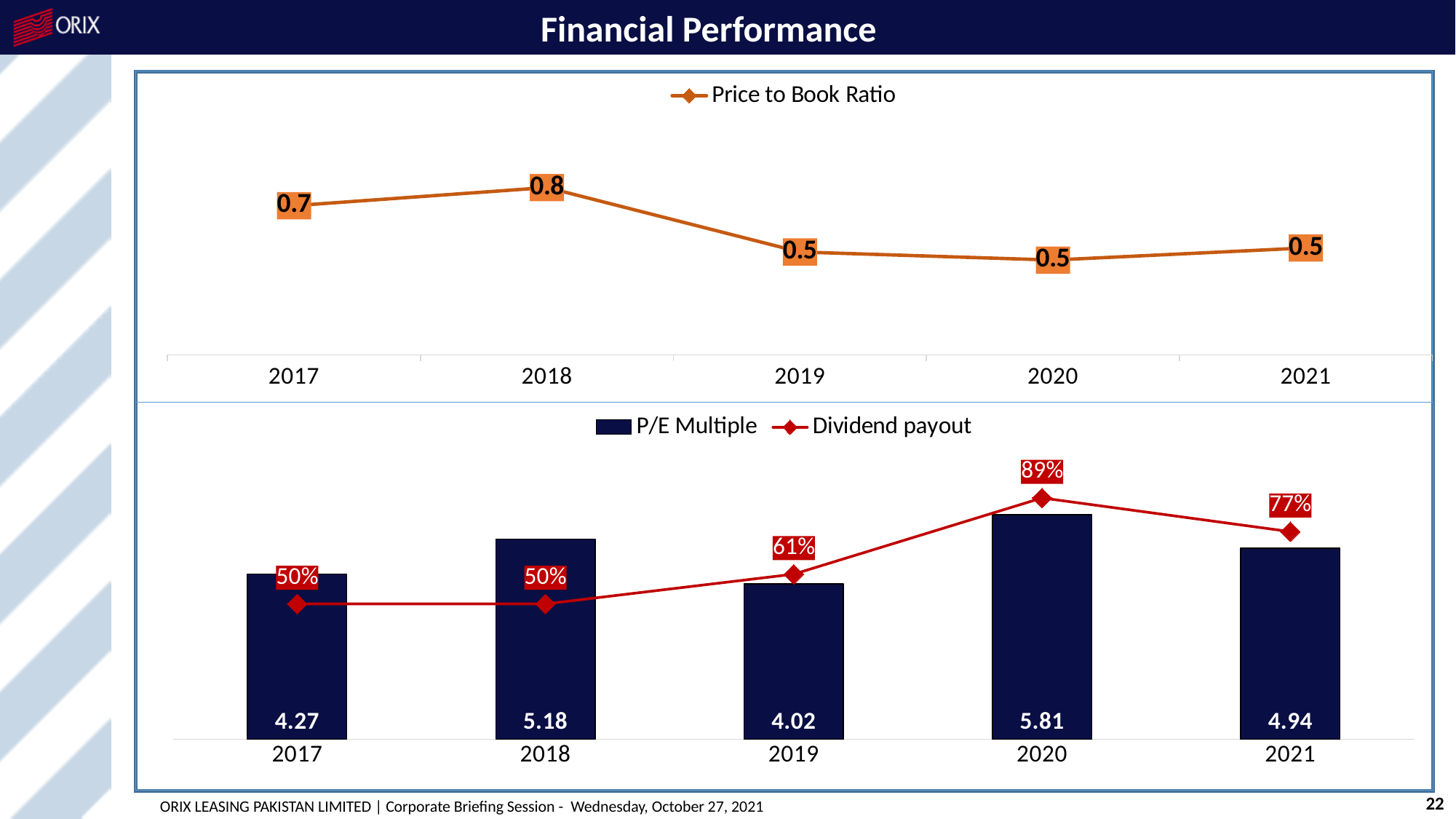
In the bottom chart, how many series does the legend list? 2 In the top chart (Price to Book Ratio), what is the value for 2018? 0.8 In the top chart (Price to Book Ratio), what is the difference between the 2018 and 2019 values? 0.3 In the bottom chart, what is the P/E Multiple for 2020? 5.81 In the bottom chart, which year has the highest Dividend payout? 2020 In the bottom chart, which year has the lowest P/E Multiple? 2019 In the bottom chart, what is the difference between the P/E Multiple for 2020 and 2019? 1.79 In the top chart (Price to Book Ratio), what kind of chart is it? line chart In the top chart (Price to Book Ratio), how many years are plotted? 5 In the bottom chart, is the P/E Multiple larger in 2018 or 2021? 2018 In the bottom chart, what is the Dividend payout for 2019? 61% In the top chart (Price to Book Ratio), which year has the highest value? 2018